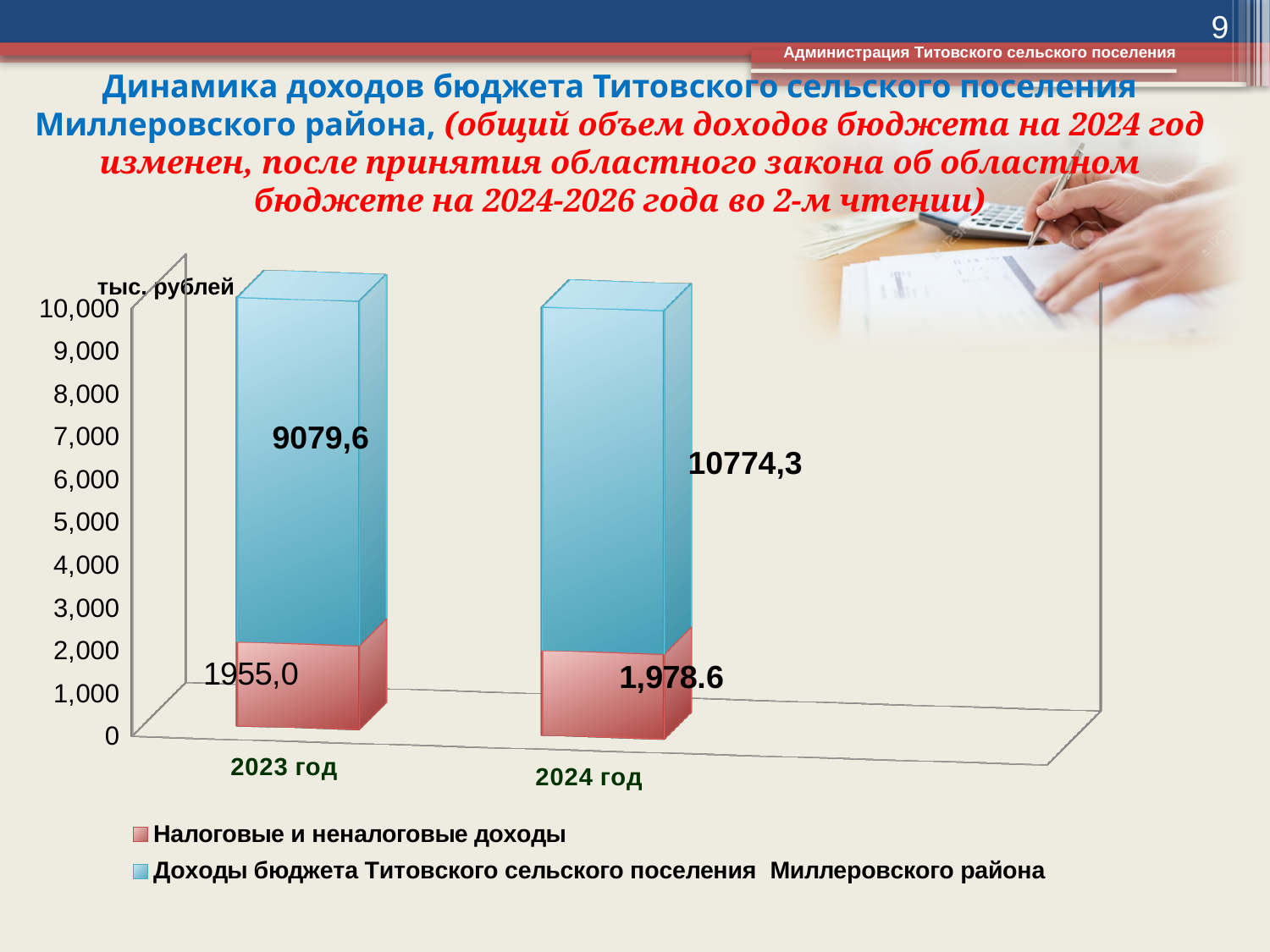
What kind of chart is shown on the slide? bar chart What is the value of 'Налоговые и неналоговые доходы' for 2024 год? 1,978.6 What is the value of 'Доходы бюджета Титовского сельского поселения Миллеровского района' for 2023 год? 9079,6 What is the value of 'Налоговые и неналоговые доходы' for 2023 год? 1955,0 How many year categories are shown on the x axis of the chart? 2 By how much does 'Доходы бюджета Титовского сельского поселения Миллеровского района' in 2024 год exceed the value in 2023 год? 1694,7 Which year has the higher value for 'Доходы бюджета Титовского сельского поселения Миллеровского района', 2023 год or 2024 год? 2024 год How many series does the chart legend list? 2 Does the value of 'Доходы бюджета Титовского сельского поселения Миллеровского района' rise or fall from 2023 год to 2024 год? rise What unit is indicated on the vertical axis of the chart? тыс. рублей What is the value of 'Доходы бюджета Титовского сельского поселения Миллеровского района' for 2024 год? 10774,3 Which colour represents 'Налоговые и неналоговые доходы' in the chart? red